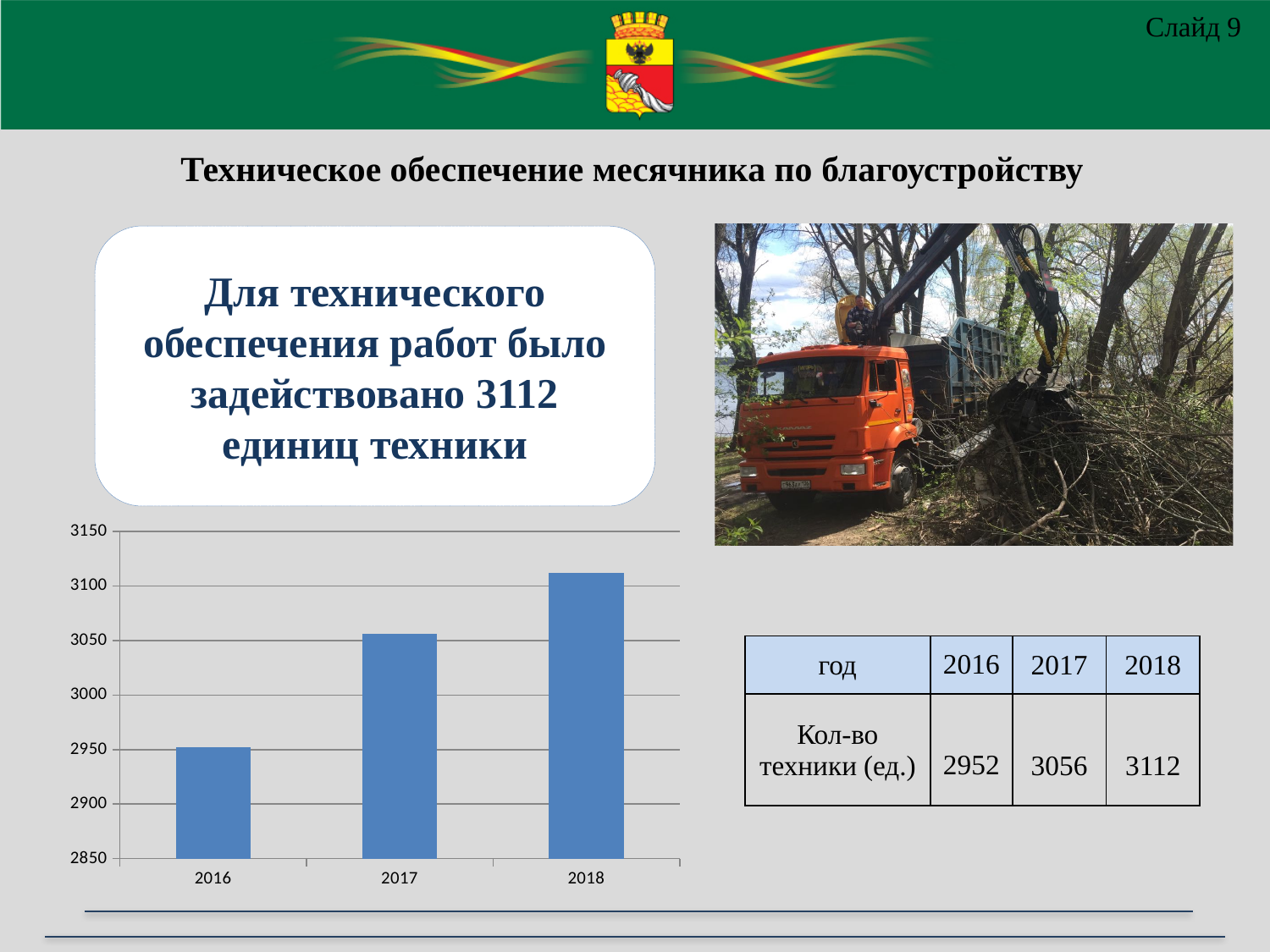
According to the table on the slide, what is the number of units of equipment (Кол-во техники) for 2016? 2952 Is the value for 2017 in the chart greater or less than 3050? greater Is the value for 2016 in the chart greater or less than 3000? less Is the value for 2018 in the chart greater or less than 3100? greater Using the values in the table on the slide, what is the difference between the 2018 and 2016 values? 160 How many bars (years) does the chart show? 3 Which year has the lowest bar in the chart? 2016 What kind of chart is shown on the slide? bar chart Which year has the highest bar in the chart? 2018 Do the values in the chart rise or fall from 2016 to 2018? rise According to the table on the slide, what is the number of units of equipment (Кол-во техники) for 2017? 3056 Which is larger in the chart, the value for 2017 or the value for 2016? 2017